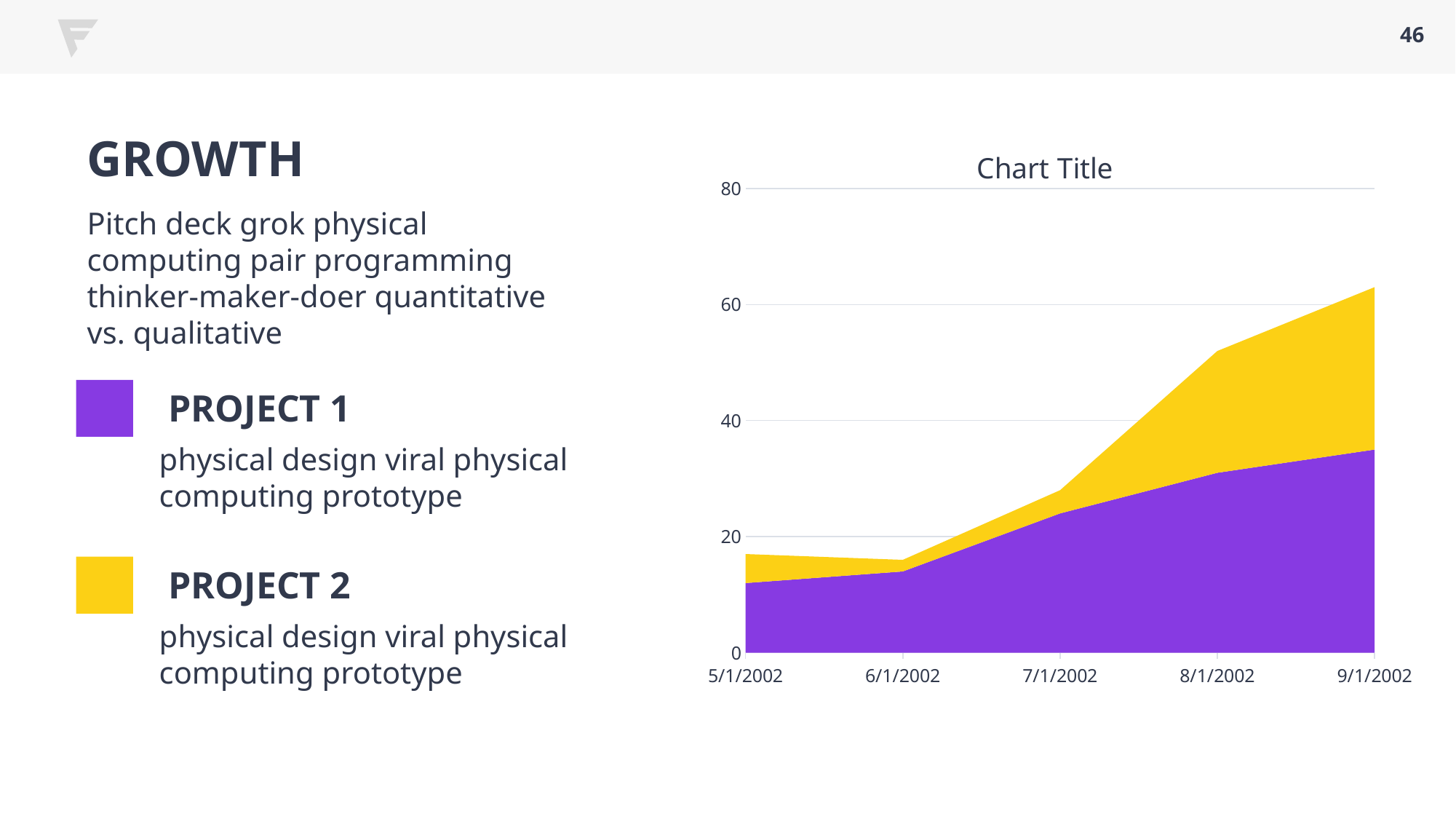
Which colour represents Project 1 in the chart? Purple Is the value for Project 1 at 9/1/2002 greater or less than 40? less At which date is the combined stacked total of both projects highest? 9/1/2002 What kind of chart is shown on the slide? Stacked area chart Is the value for Project 1 at 7/1/2002 greater or less than 20? greater What is the title of the chart? Chart Title Is the value for Project 1 at 5/1/2002 greater or less than 20? less At which date does the Project 1 series reach its highest value? 9/1/2002 How many dates are shown along the x axis of the chart? 5 Does the Project 1 area rise or fall from 6/1/2002 to 9/1/2002? Rise How many series are plotted in the chart? 2